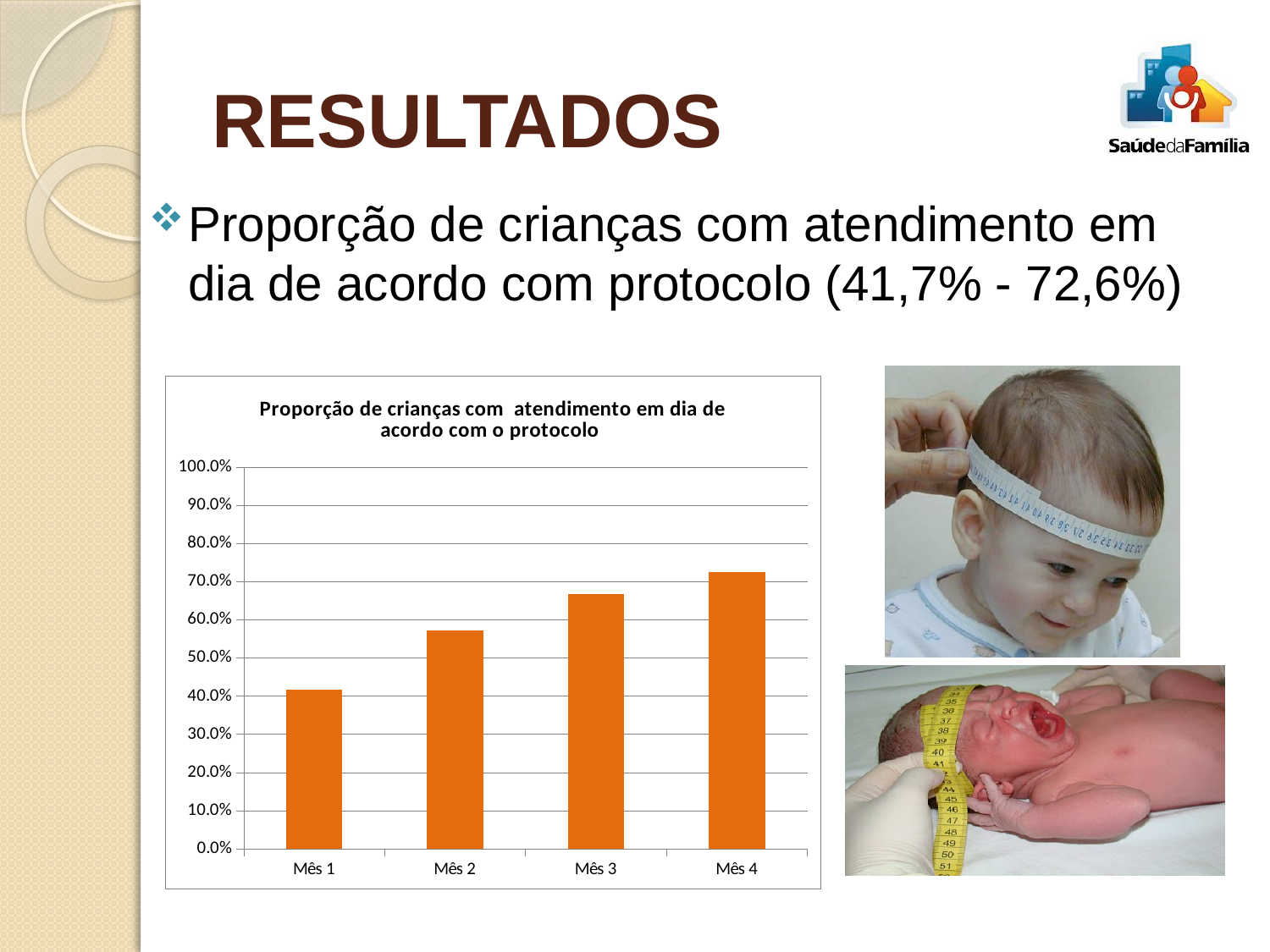
What colour are the bars in the chart? orange Is the value for Mês 1 greater or less than 50.0%? less Is the value for Mês 3 greater or less than 60.0%? greater Do the values rise or fall from Mês 1 to Mês 4? rise What kind of chart is shown on the slide? bar chart Which month has the lowest bar in the chart? Mês 1 How many categories (months) are plotted on the x axis of the chart? 4 Which month has the highest bar in the chart? Mês 4 Which is larger, the value for Mês 2 or the value for Mês 3? Mês 3 Is the value for Mês 2 greater or less than 50.0%? greater What is the title of the chart? Proporção de crianças com atendimento em dia de acordo com o protocolo